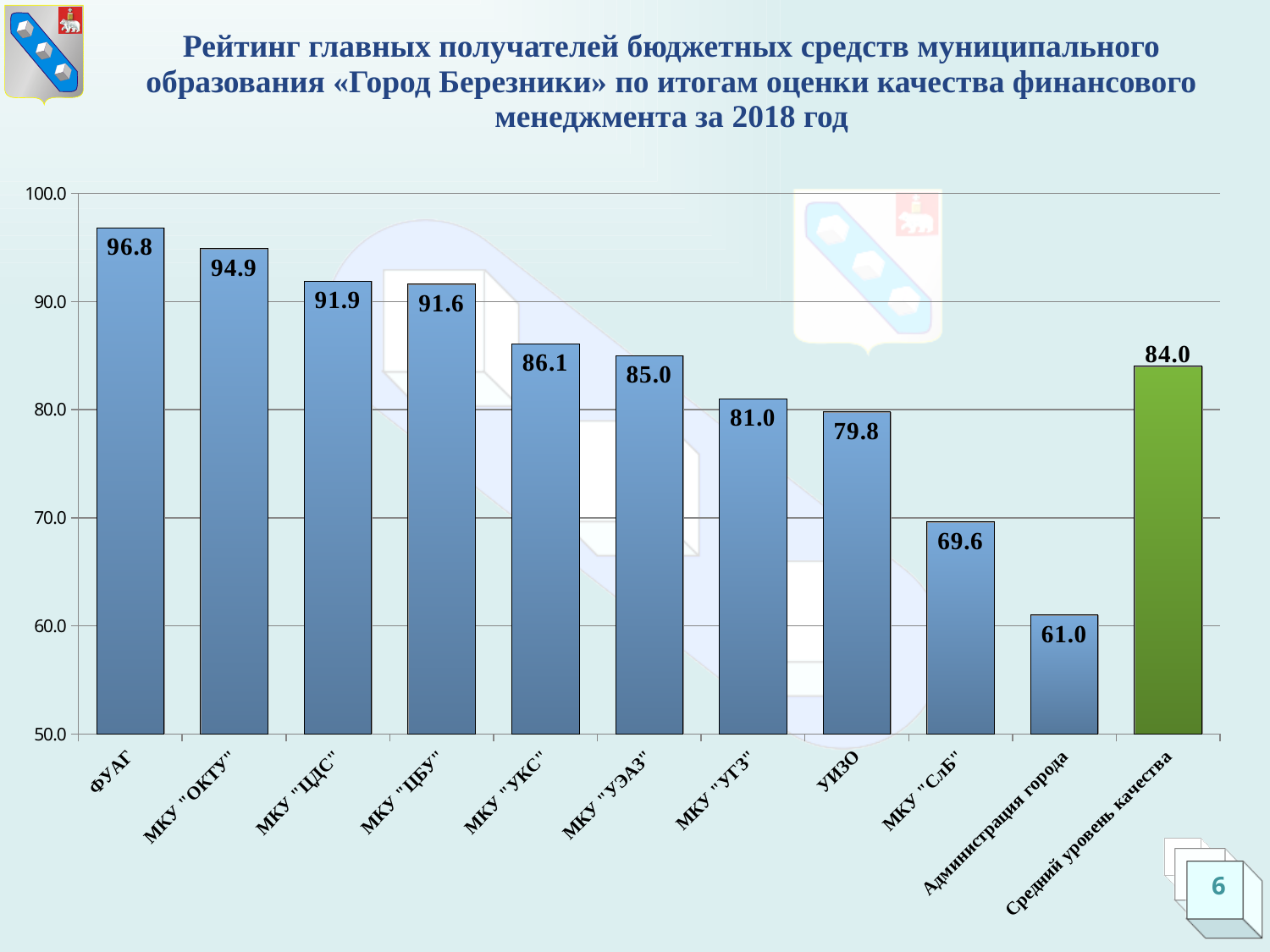
What is the value for ФУАГ? 96.8 Is the value for МКУ "УЭАЗ" greater or less than 80.0? greater What kind of chart is shown on the slide? bar chart Which category has the lowest value? Администрация города What is the value for МКУ "УКС"? 86.1 Which is larger, the value for МКУ "СлБ" or the value for УИЗО? УИЗО What is the value of the green bar labelled Средний уровень качества? 84.0 Which category has the highest value? ФУАГ What is the difference between the values for ФУАГ and Администрация города? 35.8 What is the difference between the values for МКУ "УГЗ" and УИЗО? 1.2 What is the value for Администрация города? 61.0 How many bars are shown in the chart? 11